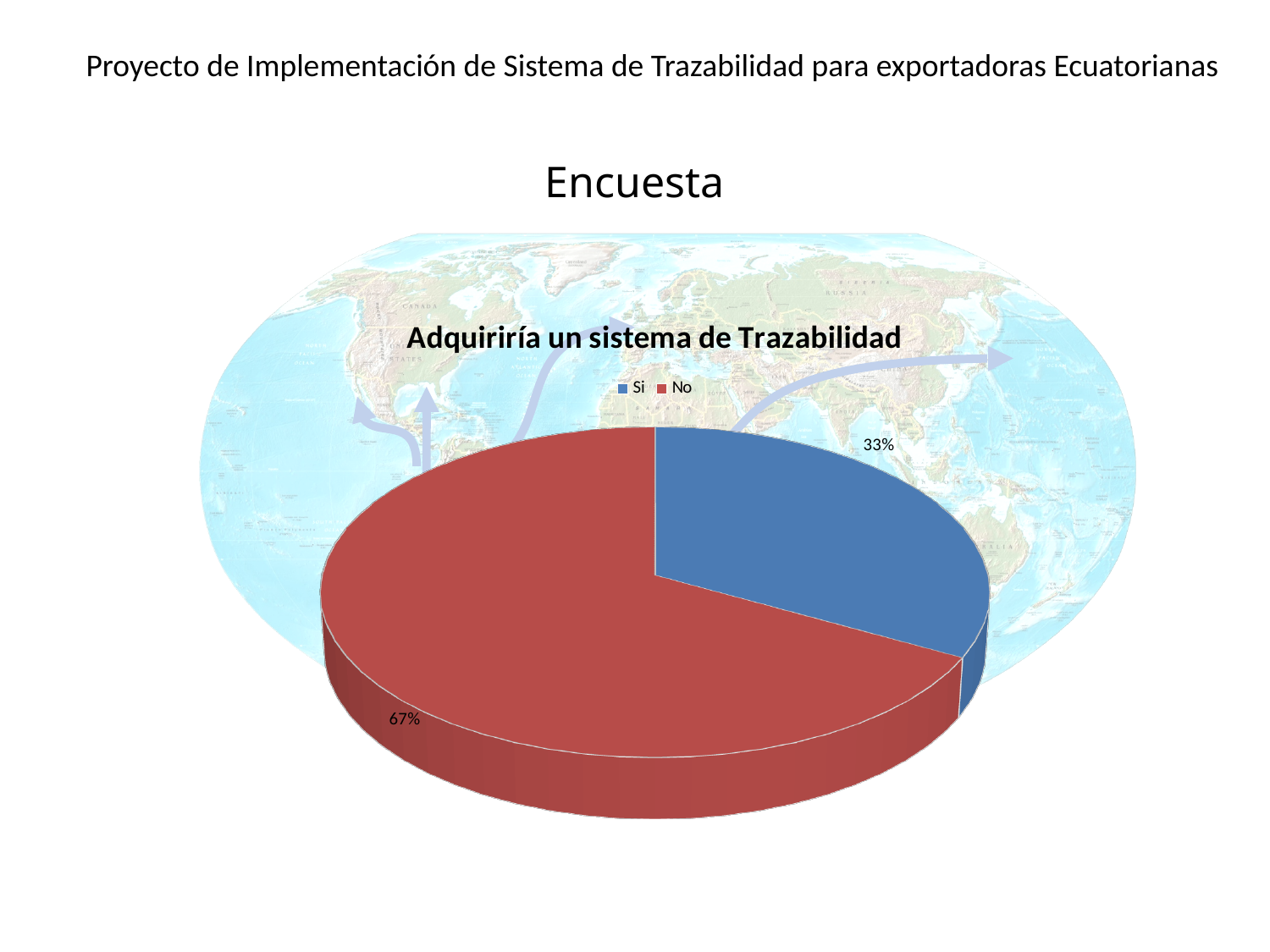
How many entries does the legend list? 2 What percentage of the pie is labelled for the 'No' slice? 67% What kind of chart is shown on the slide? pie chart What percentage of the pie is labelled for the 'Si' slice? 33% Which slice is the largest in the pie chart? No Which is larger, the 'Si' slice or the 'No' slice? No What is the share of the pie taken by the 'Si' slice? 33% What is the difference in percentage points between the 'No' slice and the 'Si' slice? 34 How many slices does the pie chart have? 2 What colour is the 'No' slice in the pie chart? red What is the title of the chart? Adquiriría un sistema de Trazabilidad Which slice is the smallest in the pie chart? Si